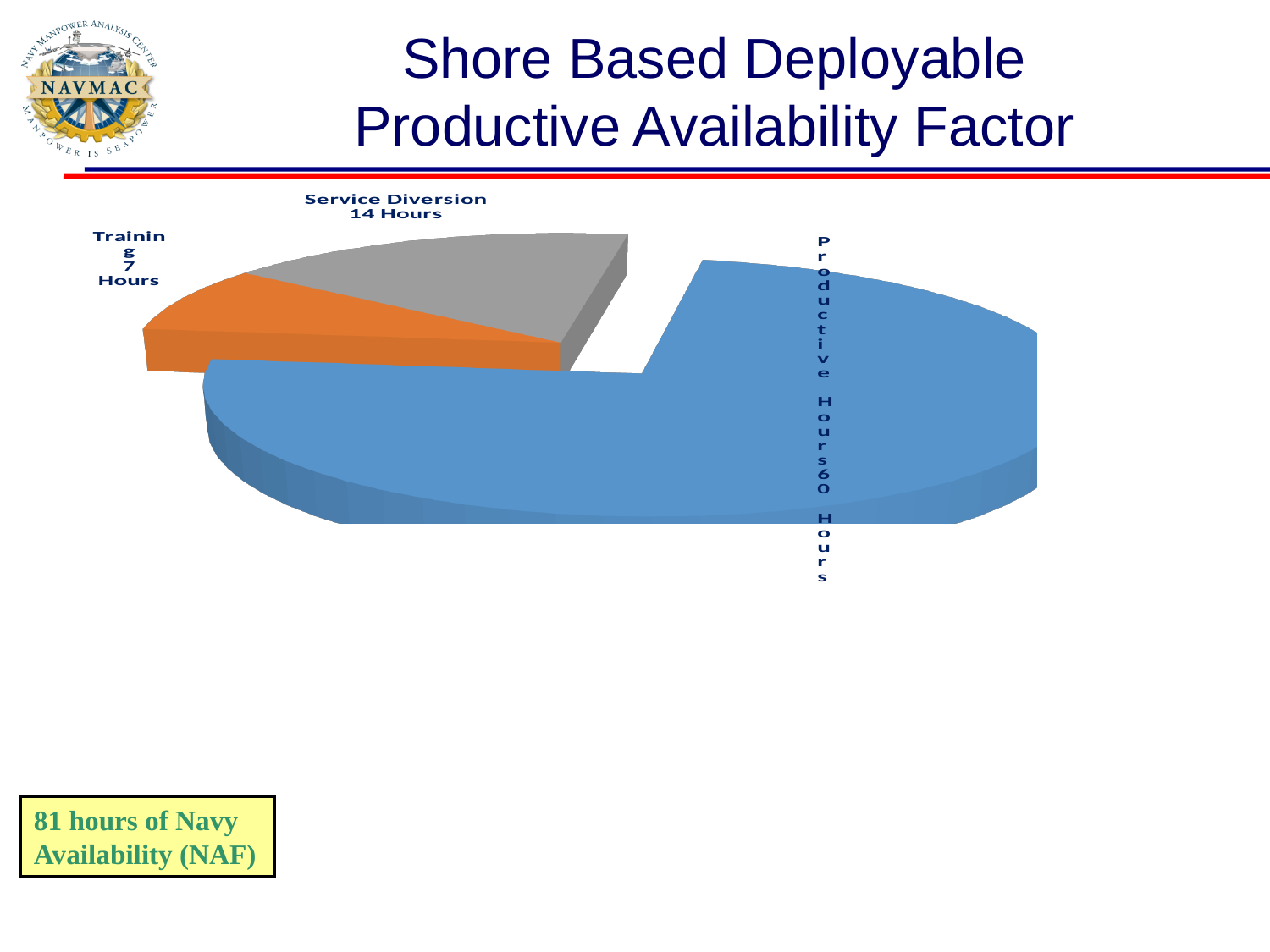
How many hours are shown for Productive Hours? 60 Hours What is the difference in hours between Service Diversion and Training? 7 Hours What colour is the Productive Hours slice? blue How many hours are shown for Training? 7 Hours Which slice of the pie chart is the largest? Productive Hours What is the difference in hours between Productive Hours and Service Diversion? 46 Hours How many hours are shown for Service Diversion? 14 Hours What kind of chart is shown on the slide? pie chart Which slice of the pie chart is the smallest? Training Which is larger, Service Diversion or Training? Service Diversion What is the total number of hours across all three slices of the pie chart? 81 hours How many slices does the pie chart have? 3